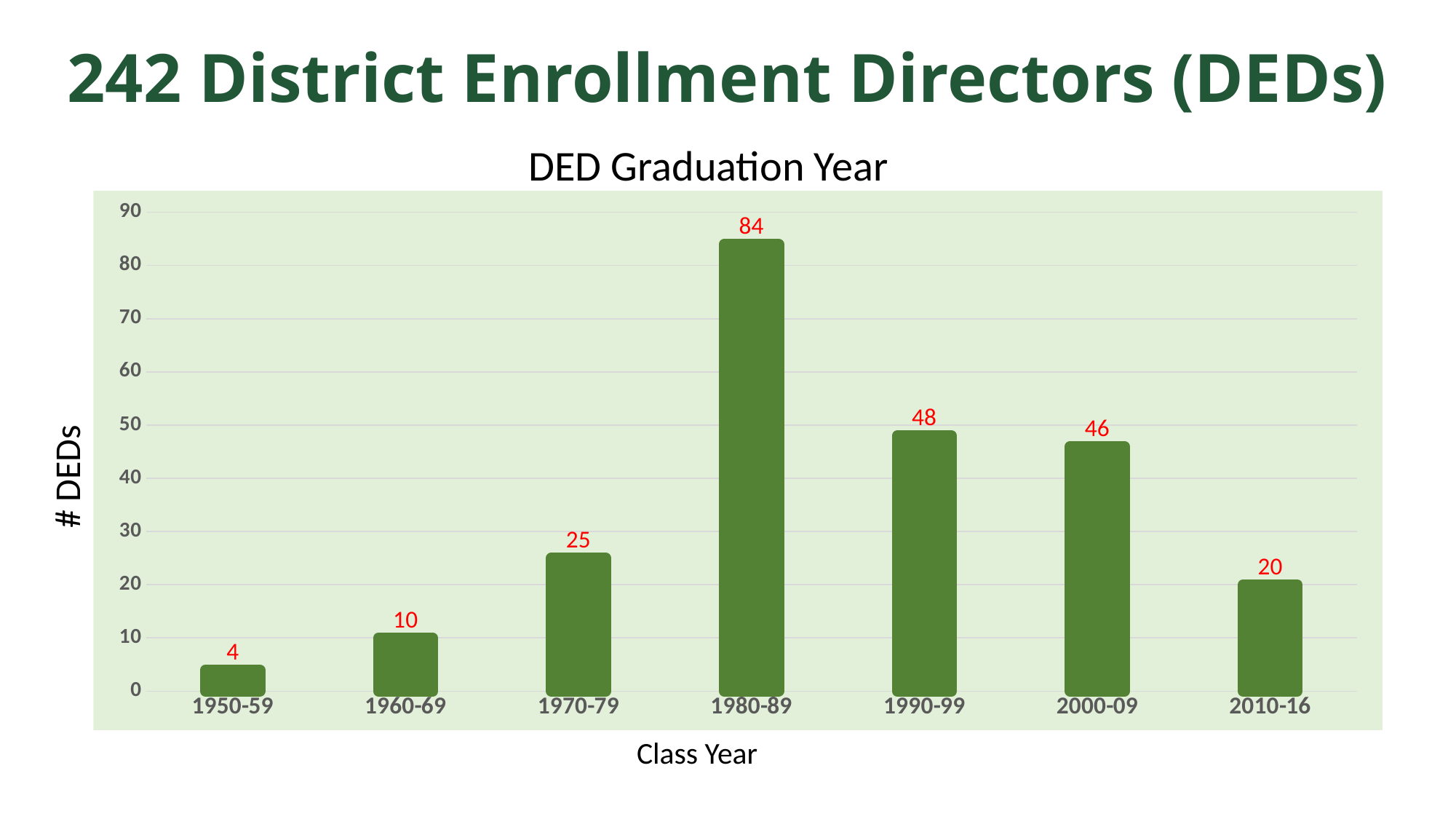
Is the value for the 2000-09 class year greater or less than 50? less How many class year categories are shown on the chart? 7 What is the number of DEDs for the 2010-16 class year? 20 What kind of chart is shown on the slide? Bar chart What is the difference in the number of DEDs between the 1980-89 and 1990-99 class years? 36 Which class year has the lowest number of DEDs? 1950-59 How many DEDs graduated in the 1980-89 class years? 84 What is the label of the vertical axis? # DEDs Which class year has the highest number of DEDs? 1980-89 What is the title of the chart? DED Graduation Year Which has more DEDs, the 1970-79 class year or the 2010-16 class year? 1970-79 How many DEDs are shown for the 1950-59 class year? 4